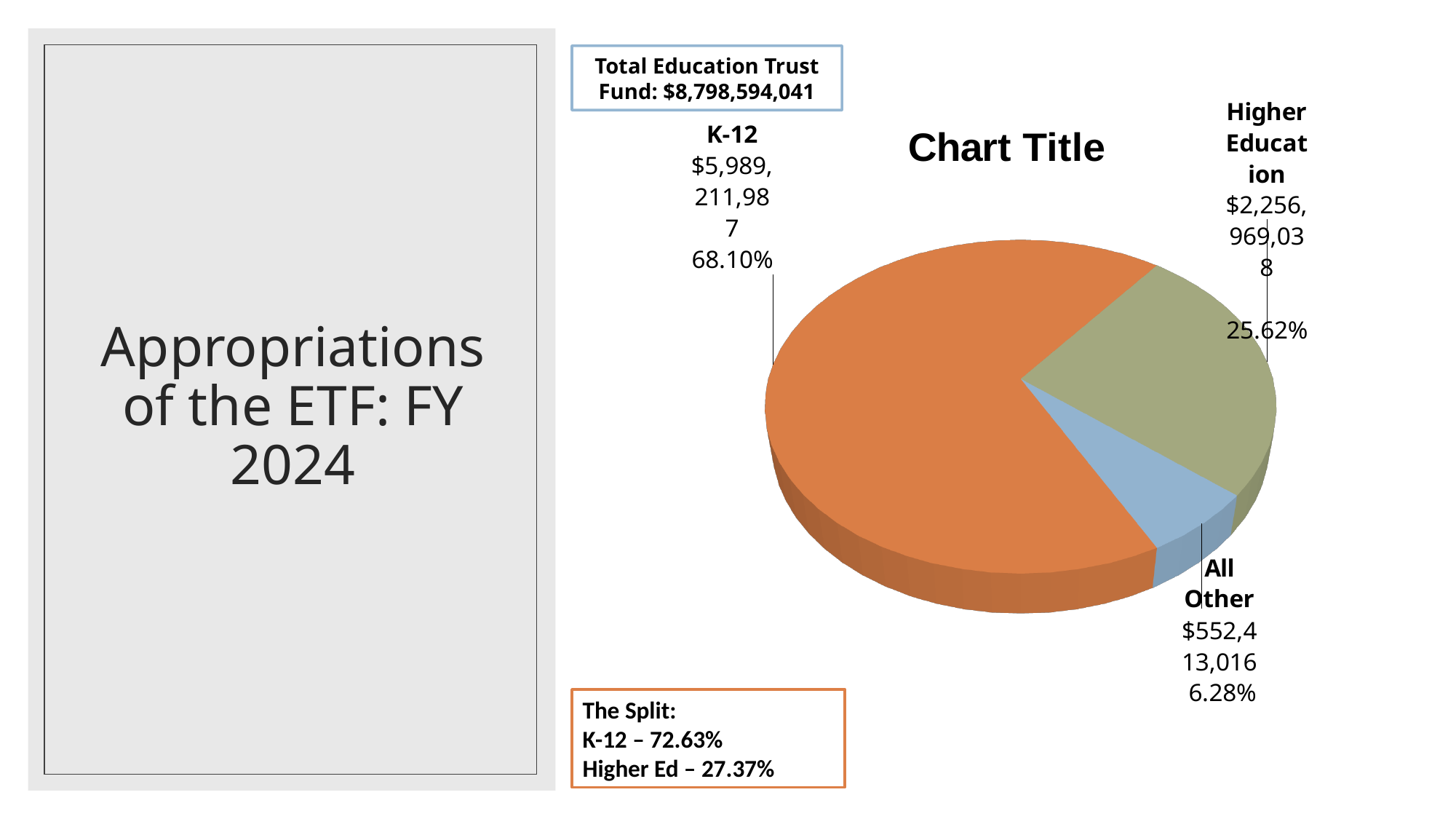
Which is larger, the Higher Education slice or the All Other slice? Higher Education What is the dollar value shown for the All Other slice? $552,413,016 What is the dollar value shown for the K-12 slice? $5,989,211,987 What is the dollar value shown for the Higher Education slice? $2,256,969,038 Which slice of the pie is the smallest? All Other Which slice of the pie is the largest? K-12 What share of the pie does the Higher Education slice represent? 25.62% What share of the pie does the All Other slice represent? 6.28% How many slices does the pie chart have? 3 What type of chart is shown on the slide? pie chart What share of the pie does the K-12 slice represent? 68.10% What is the difference in percentage points between the K-12 share and the Higher Education share? 42.48%